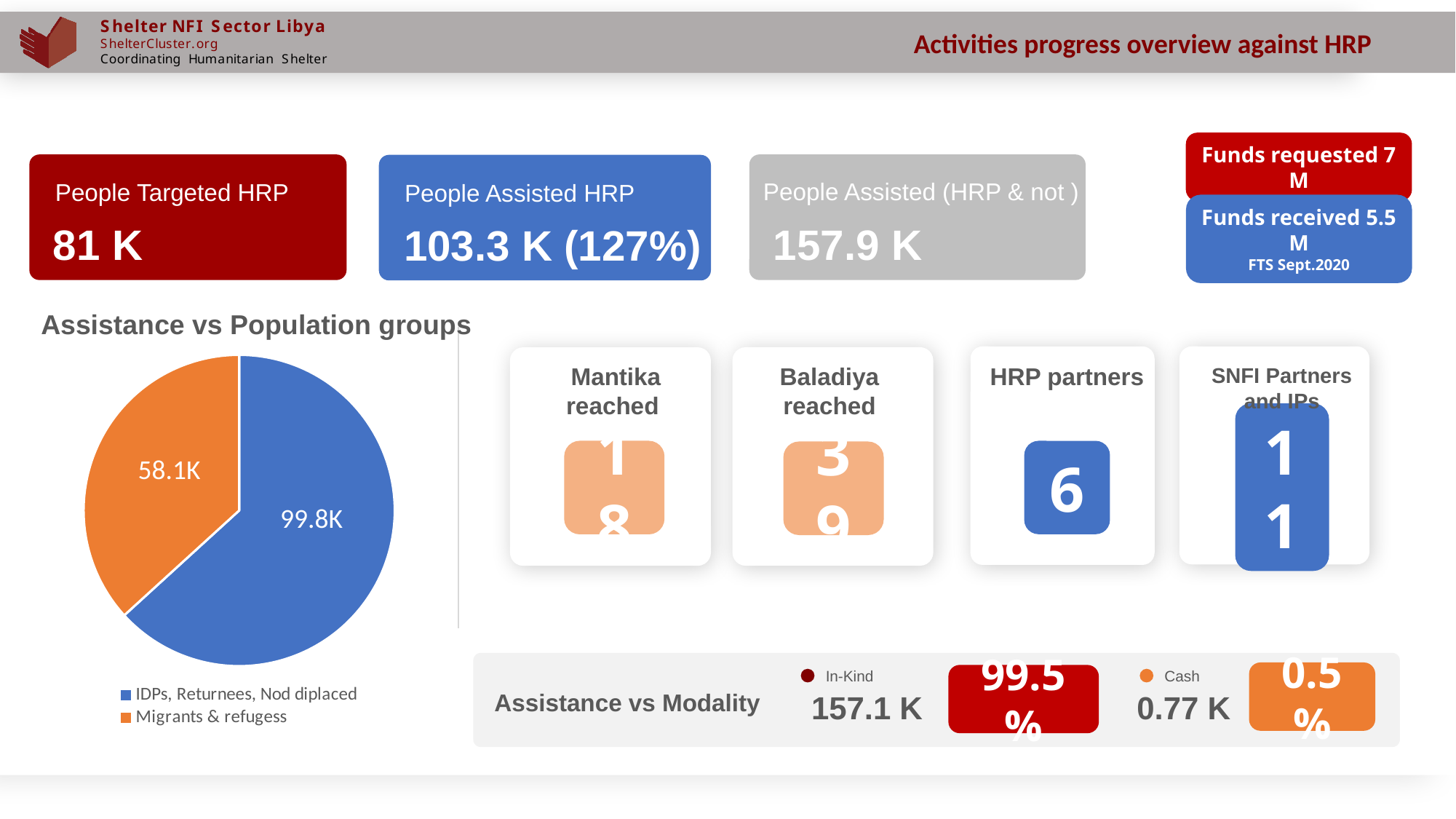
What is the title of the pie chart on the slide? Assistance vs Population groups In the 'Assistance vs Population groups' pie chart, which is larger: Migrants & refugess or IDPs, Returnees, Nod diplaced? IDPs, Returnees, Nod diplaced What type of chart is used for 'Assistance vs Population groups'? pie chart Which slice of the 'Assistance vs Population groups' pie chart is the smallest? Migrants & refugess How many entries does the legend of the 'Assistance vs Population groups' pie chart list? 2 In the 'Assistance vs Population groups' pie chart, what is the value for Migrants & refugess? 58.1K In the 'Assistance vs Population groups' pie chart, what is the value for IDPs, Returnees, Nod diplaced? 99.8K How many slices does the 'Assistance vs Population groups' pie chart have? 2 What is the total of the two slices in the 'Assistance vs Population groups' pie chart? 157.9K In the 'Assistance vs Population groups' pie chart, what is the difference between the IDPs, Returnees, Nod diplaced value and the Migrants & refugess value? 41.8K Which slice of the 'Assistance vs Population groups' pie chart is the largest? IDPs, Returnees, Nod diplaced What colour is the Migrants & refugess slice in the 'Assistance vs Population groups' pie chart? orange